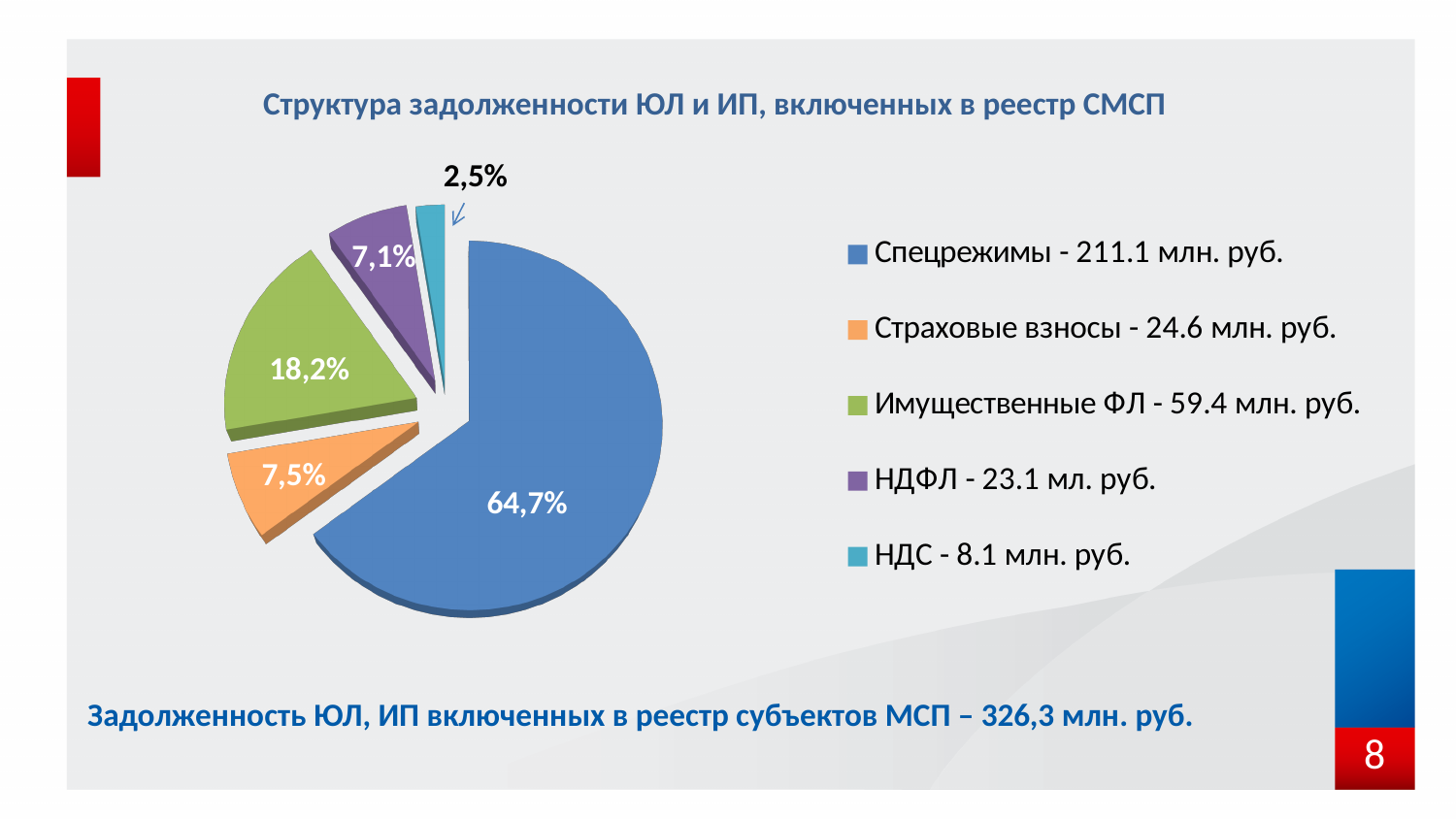
Which slice is larger, Страховые взносы or НДФЛ? Страховые взносы What share of the pie does Имущественные ФЛ account for? 18,2% What kind of chart is shown on the slide? pie chart What share of the pie does Страховые взносы account for? 7,5% Which category has the largest slice of the pie? Спецрежимы According to the legend, what is the debt amount for Имущественные ФЛ? 59.4 млн. руб. How many slices does the pie chart have? 5 Which category has the smallest slice of the pie? НДС What share of the pie does Спецрежимы account for? 64,7% According to the legend, what is the debt amount for НДФЛ? 23.1 мл. руб. What is the difference in percentage points between the Спецрежимы slice and the Имущественные ФЛ slice? 46,5%